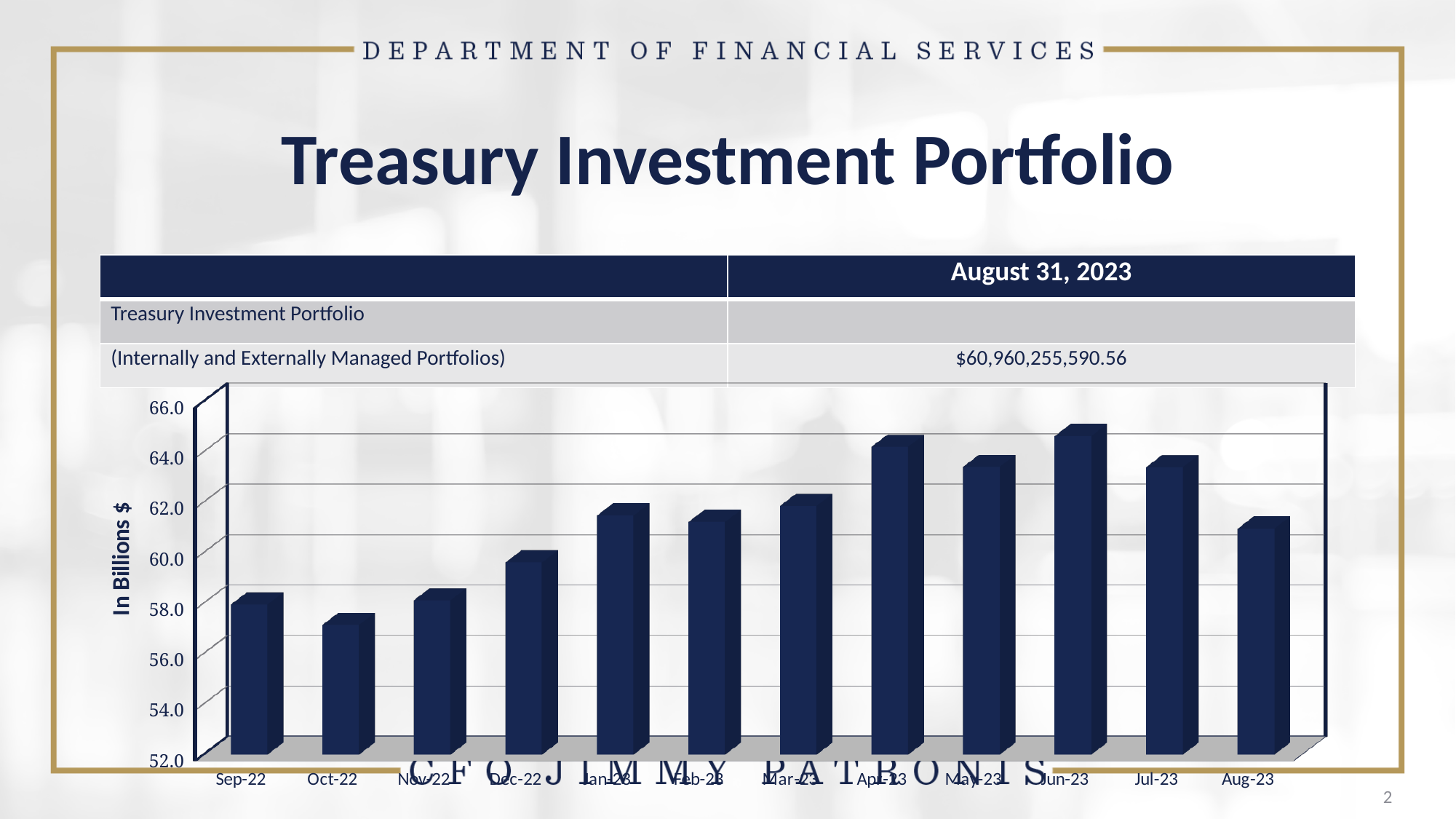
How many months are plotted on the x axis of the chart? 12 Is the value for Oct-22 greater or less than 58.0? less Is the value for Dec-22 greater or less than 58.0? greater What is the label on the vertical axis of the chart? In Billions $ What kind of chart is shown on the slide? bar chart Which is larger, the bar for Jun-23 or the bar for Aug-23? Jun-23 Is the value for Aug-23 greater or less than 60.0? greater Which month has the highest bar in the chart? Jun-23 Do the bars generally rise or fall from Sep-22 to Jun-23? rise Which month has the lowest bar in the chart? Oct-22